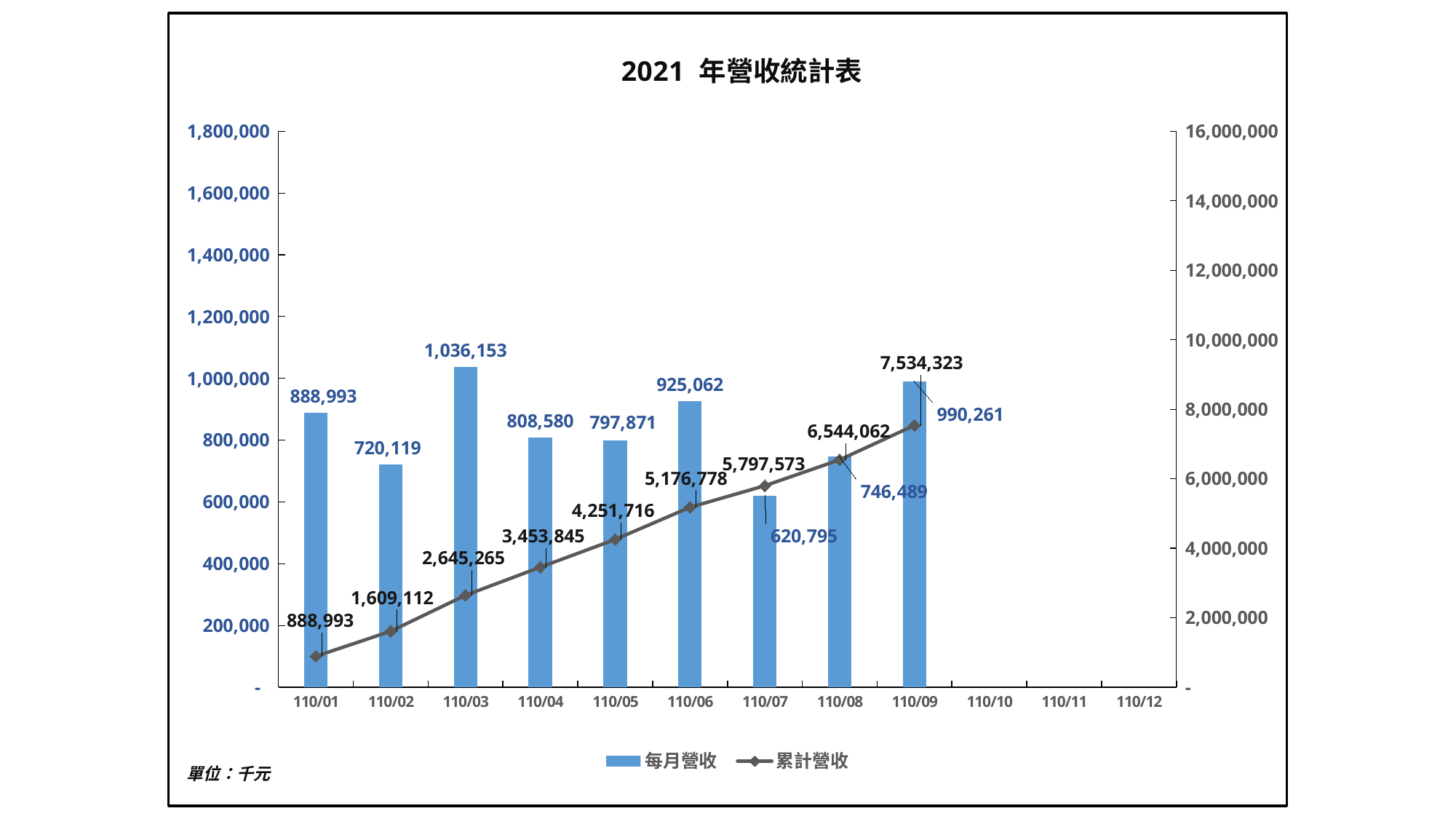
What is the monthly revenue (每月營收) for 110/07? 620,795 What is the difference between the monthly revenue for 110/03 and 110/02? 316,034 Is the monthly revenue for 110/03 greater or less than 1,000,000? greater What kind of chart is this? Combined bar and line chart Does the cumulative revenue (累計營收) line rise or fall from 110/01 to 110/09? Rise Which month has the highest monthly revenue (每月營收)? 110/03 Which month has the larger monthly revenue, 110/06 or 110/09? 110/09 How many series does the legend list? 2 What is the cumulative revenue (累計營收) value at 110/09? 7,534,323 Which month has the lowest monthly revenue (每月營收)? 110/07 How many months have a monthly revenue bar plotted? 9 What is the monthly revenue (每月營收) for 110/03? 1,036,153